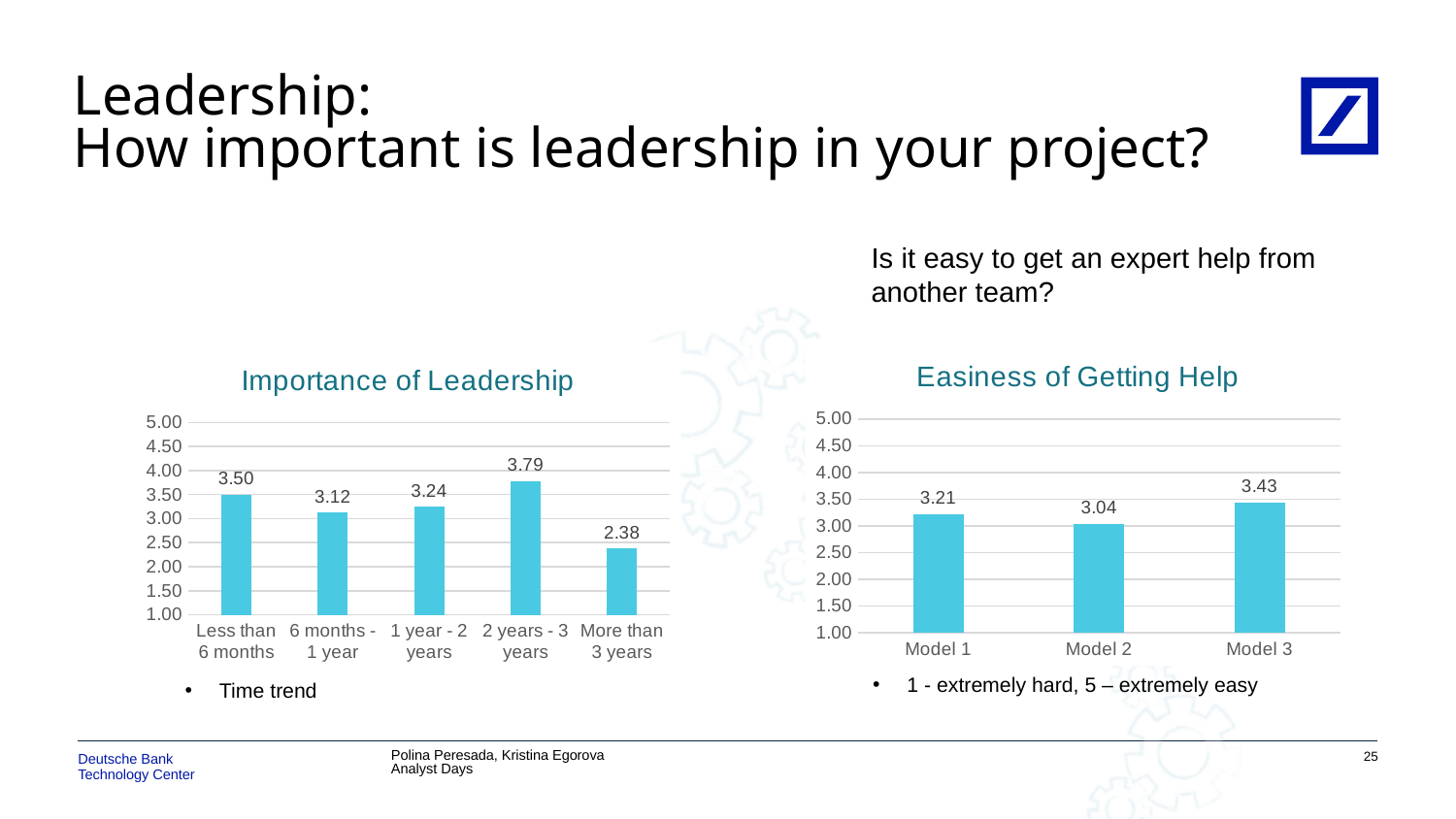
In the 'Importance of Leadership' chart, what is the value for '2 years - 3 years'? 3.79 In the 'Importance of Leadership' chart, which category has the highest value? 2 years - 3 years In the 'Easiness of Getting Help' chart, what is the difference between the values for Model 3 and Model 1? 0.22 What kind of chart is the 'Easiness of Getting Help' chart? Bar chart In the 'Easiness of Getting Help' chart, which model has the highest value? Model 3 In the 'Easiness of Getting Help' chart, what is the value for Model 2? 3.04 In the 'Importance of Leadership' chart, is the value for '6 months - 1 year' greater or less than 3.50? less In the 'Easiness of Getting Help' chart, which is larger, the value for Model 1 or Model 2? Model 1 In the 'Importance of Leadership' chart, what is the difference between the values for '2 years - 3 years' and 'More than 3 years'? 1.41 In the 'Importance of Leadership' chart, which category has the lowest value? More than 3 years In the 'Importance of Leadership' chart, what is the value for 'Less than 6 months'? 3.50 In the 'Importance of Leadership' chart, how many categories are shown? 5